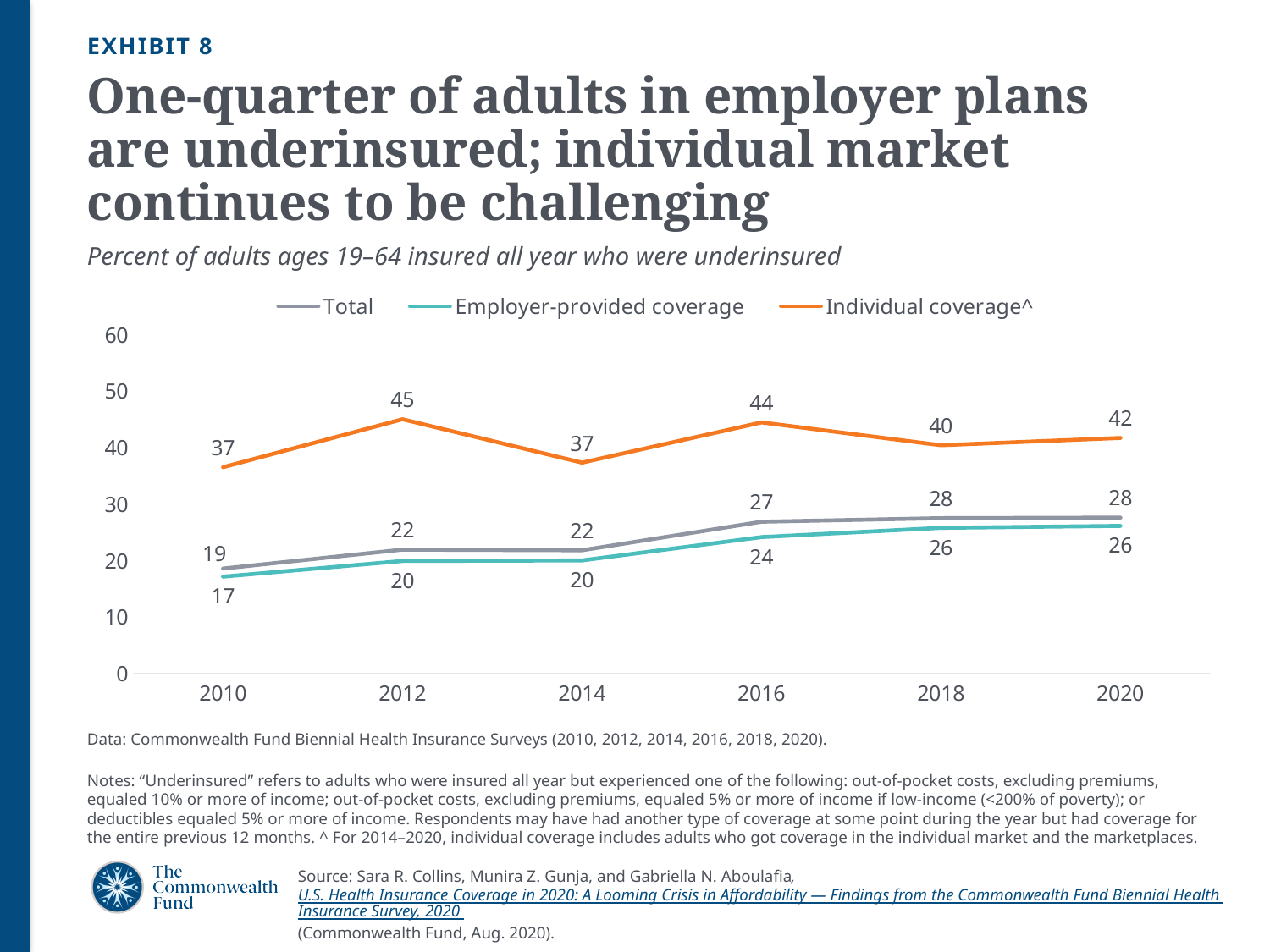
What was the value for Employer-provided coverage in 2010? 17 Did the Employer-provided coverage values generally rise or fall from 2010 to 2020? Rise In which year was the Total value lowest? 2010 What was the value for Individual coverage in 2012? 45 How many years are plotted along the x axis? 6 Which was larger in 2018: Individual coverage or Total? Individual coverage Which series is drawn in orange? Individual coverage^ In which year was Individual coverage highest? 2012 What was the Total value in 2016? 27 How many series does the legend list? 3 What is the difference between Individual coverage and Employer-provided coverage in 2020? 16 What kind of chart is shown on the slide? Line chart